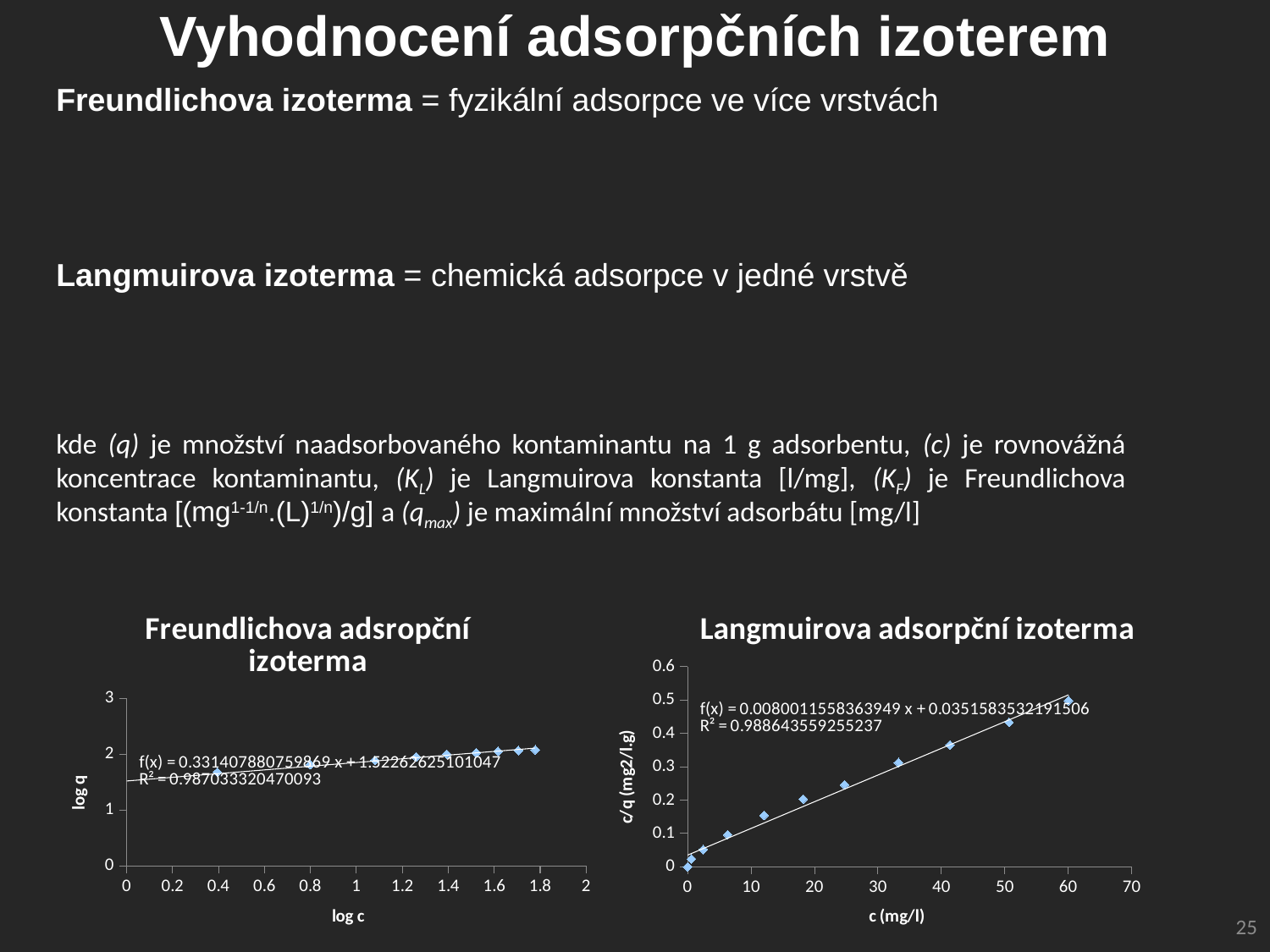
In the 'Freundlichova adsropční izoterma' chart, do the plotted values rise or fall as log c increases? rise In the 'Langmuirova adsorpční izoterma' chart, is the c/q value for the point near c = 33 mg/l greater or less than 0.2? greater In the 'Langmuirova adsorpční izoterma' chart, do the plotted values rise or fall as c (mg/l) increases? rise In the 'Freundlichova adsropční izoterma' chart, is the log q value for the point near log c = 0.4 greater or less than 1? greater In the 'Langmuirova adsorpční izoterma' chart, is the c/q value for the point at c = 60 mg/l greater or less than 0.4? greater What kind of chart is the 'Langmuirova adsorpční izoterma' chart? scatter chart What is the R² value shown on the 'Langmuirova adsorpční izoterma' chart? 0.988643559255237 What is the label of the x axis of the 'Langmuirova adsorpční izoterma' chart? c (mg/l) What kind of chart is the 'Freundlichova adsropční izoterma' chart? scatter chart